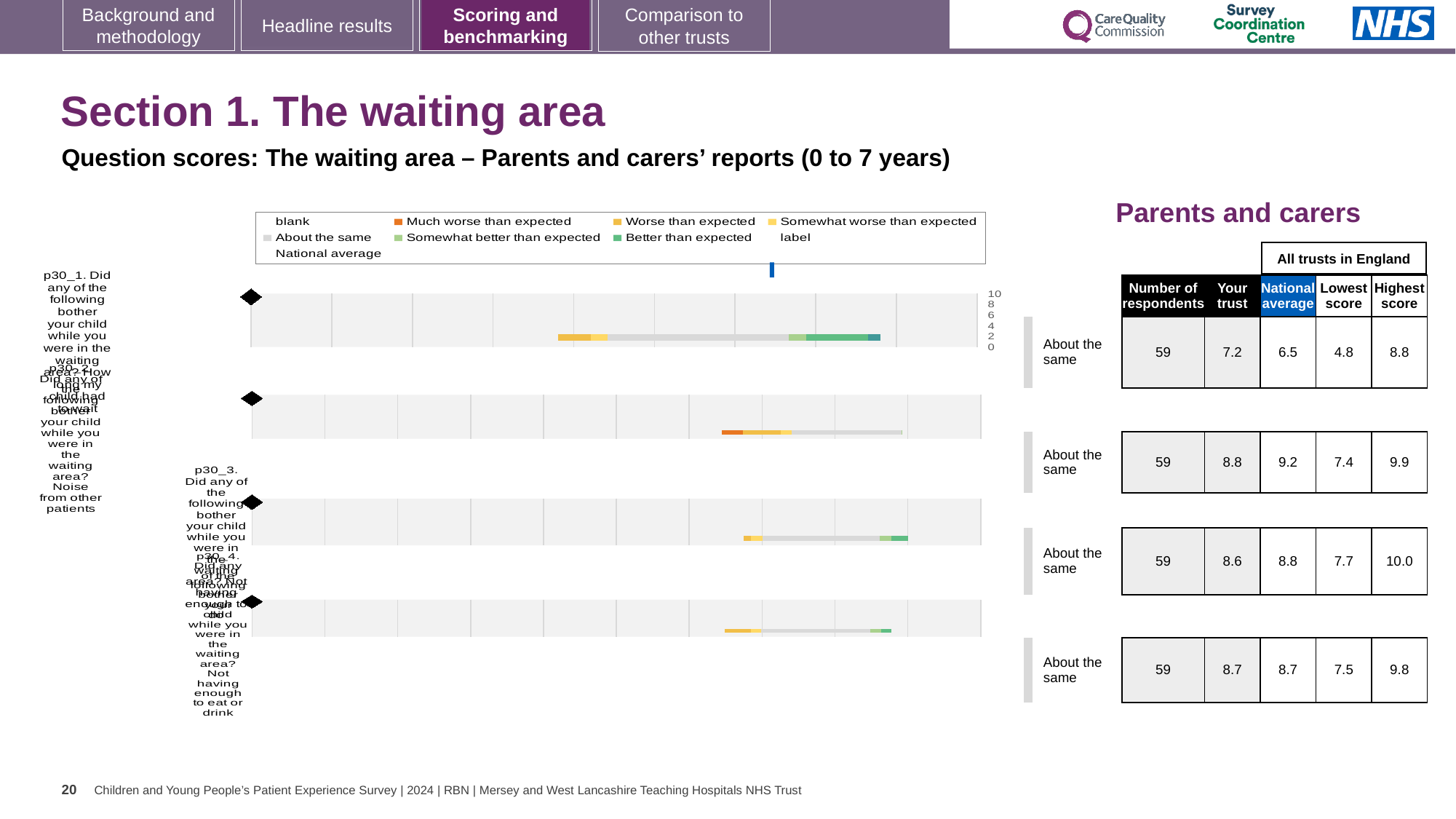
What is the highest tick value shown on the chart's value axis? 10 How many question bars are plotted in the chart? 4 Which legend entry is shown in orange? Much worse than expected Which legend entry is shown in dark green? Better than expected What kind of chart is shown on the slide? bar chart What is the lowest tick value shown on the chart's value axis? 0 How many entries does the chart legend list? 9